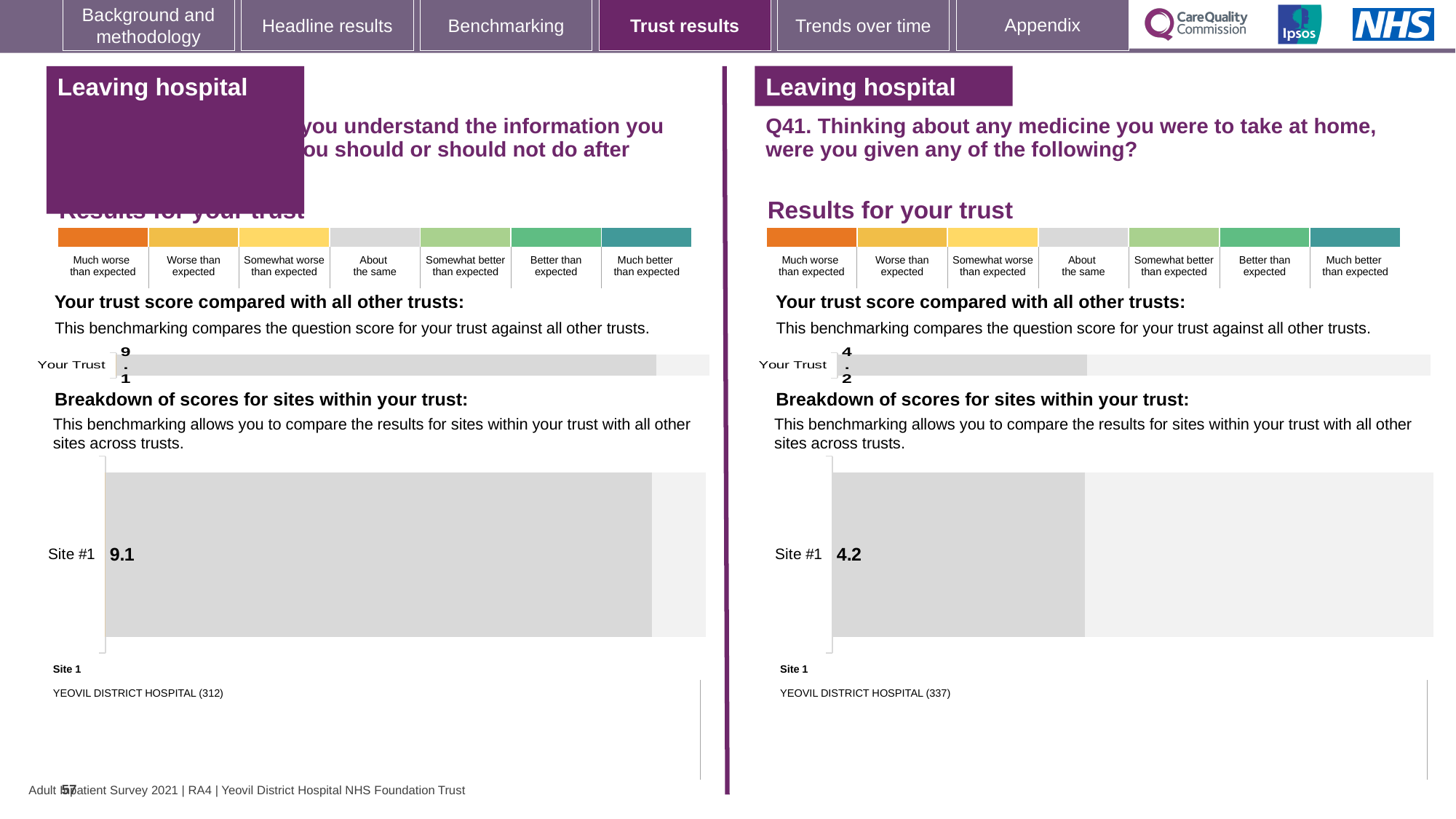
On the right-hand chart for Q41, what is the difference between the Your Trust score and the Site #1 score? 0.0 On the right-hand panel for Q41, which hospital is listed as Site 1? YEOVIL DISTRICT HOSPITAL (337) How many sites are shown in the site breakdown chart on the right-hand panel for Q41? 1 What kind of chart is used to show the Site #1 score on the right-hand panel for Q41? Bar chart Which is larger: the Site #1 score on the left-hand chart or the Site #1 score on the right-hand chart for Q41? Left-hand chart (9.1) On the left-hand chart, what is the score shown for Your Trust? 9.1 On the left-hand panel, which hospital is listed as Site 1? YEOVIL DISTRICT HOSPITAL (312) On the right-hand chart for Q41, what is the score shown for Your Trust? 4.2 On the left-hand chart, what is the difference between the Your Trust score and the Site #1 score? 0.0 On the right-hand chart for Q41, what is the score shown for Site #1? 4.2 How many sites are shown in the site breakdown chart on the left-hand panel? 1 On the left-hand chart, what is the score shown for Site #1? 9.1